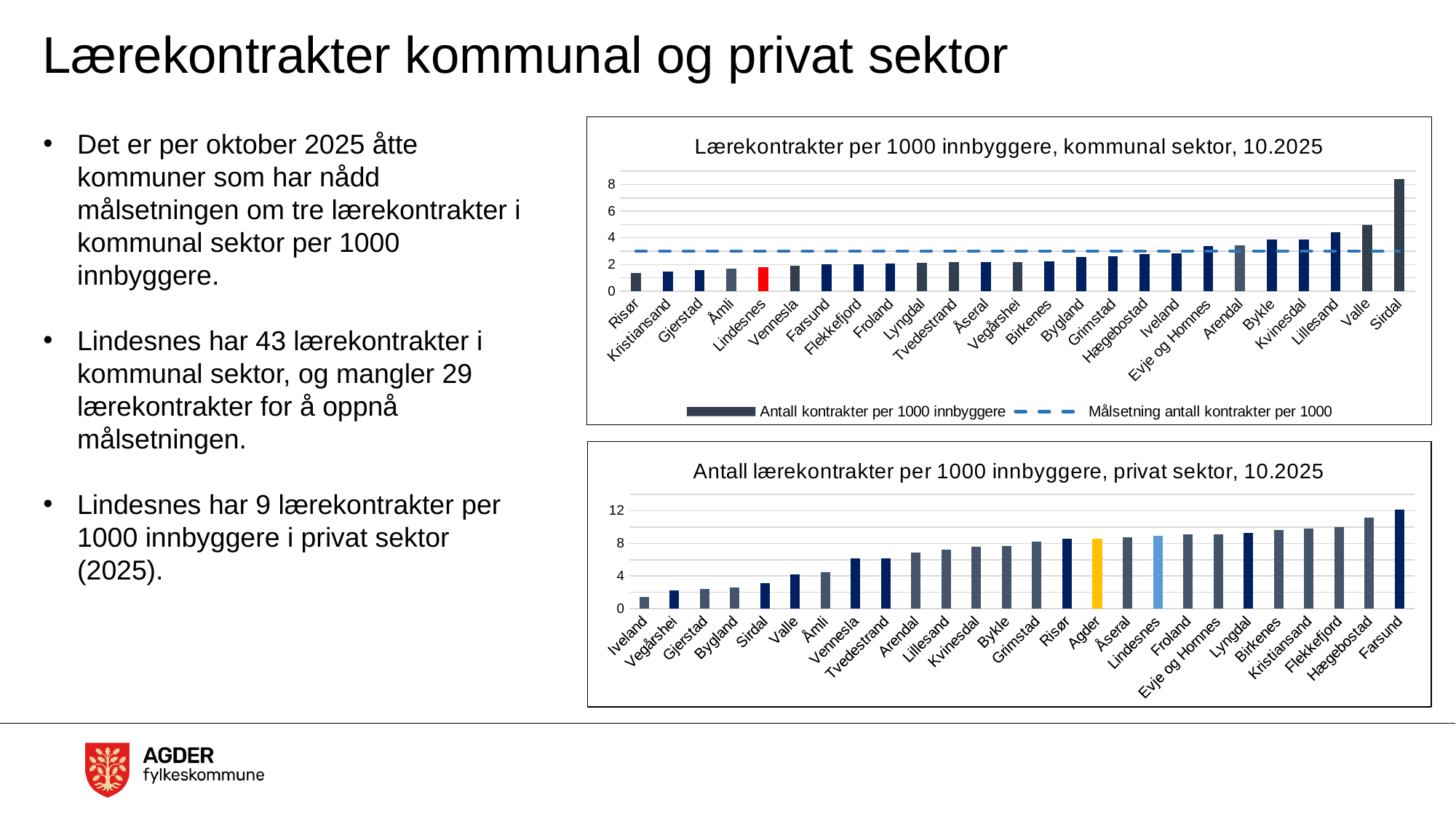
In the bottom chart (privat sektor), which municipality has the highest value? Farsund In the bottom chart (privat sektor), which municipality has the lowest value? Iveland In the top chart (kommunal sektor), is the value for Lindesnes greater or less than 2? less In the top chart (kommunal sektor), which municipality has the lowest value? Risør In the top chart (kommunal sektor), how many series does the legend list? 2 In the top chart (kommunal sektor), is the value for Sirdal greater or less than 8? greater In the bottom chart (privat sektor), which is larger: the value for Valle or the value for Vennesla? Vennesla In the top chart (kommunal sektor), which municipality has the highest number of lærekontrakter per 1000 innbyggere? Sirdal In the top chart (kommunal sektor), how many municipalities are plotted? 25 In the top chart (kommunal sektor), do the values rise or fall from left to right? rise In the bottom chart (privat sektor), is the value for Farsund greater or less than 8? greater What type of chart is the bottom chart (privat sektor)? bar chart